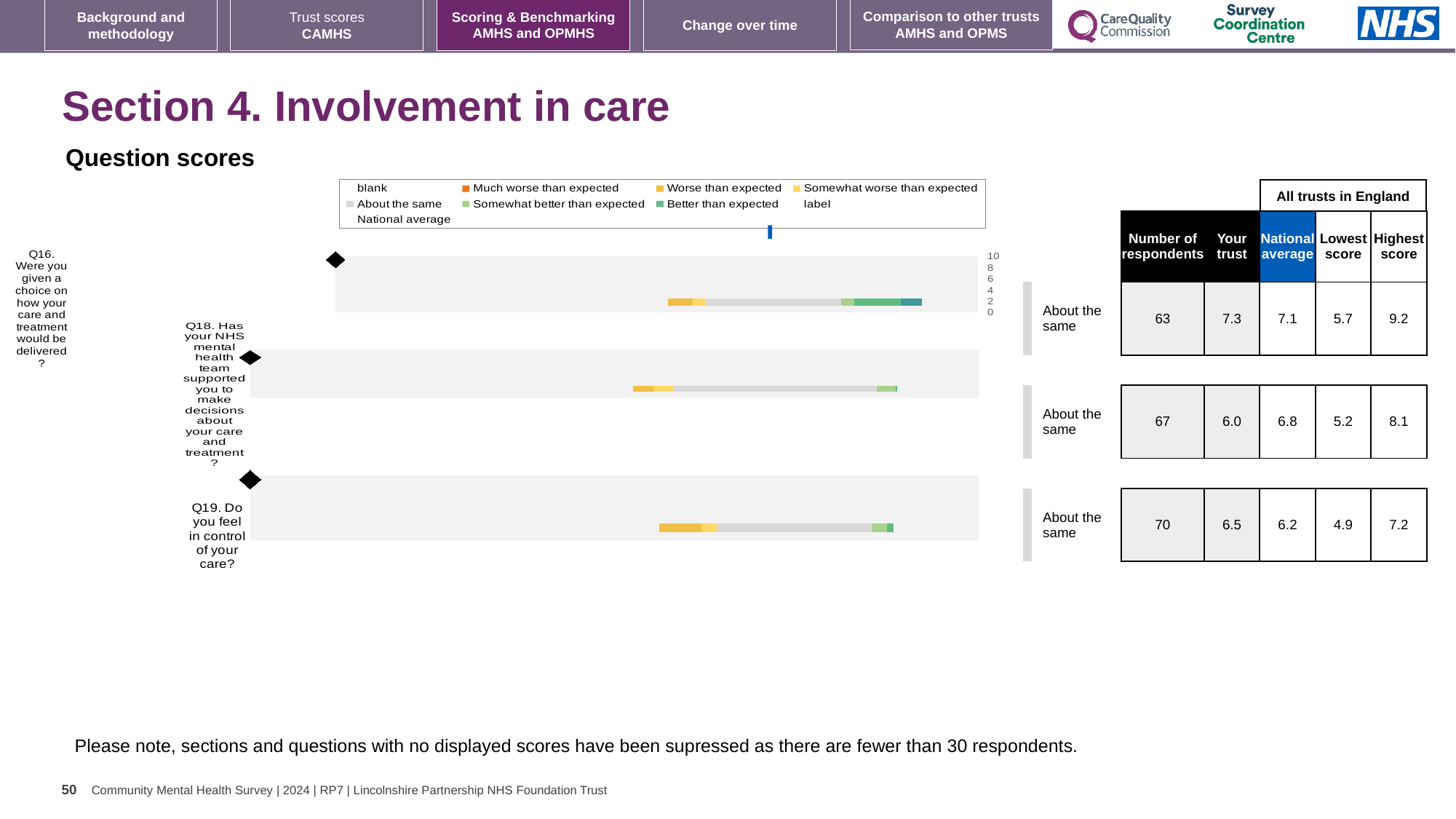
What is the national average score for Q18 (Has your NHS mental health team supported you to make decisions about your care and treatment?)? 6.8 How many questions are plotted in the question scores chart? 3 Which question has the highest 'Your trust' score? Q16 What kind of chart is used to show the question scores on this slide? bar chart What is the 'Your trust' score for Q16 (Were you given a choice on how your care and treatment would be delivered?)? 7.3 For Q18, which is larger: the 'Your trust' score or the national average? National average Which question has the lowest 'Your trust' score? Q18 How many respondents answered Q19 (Do you feel in control of your care?)? 70 What is the highest score across all trusts in England for Q16? 9.2 What is the difference between the 'Your trust' score and the national average for Q16? 0.2 What benchmark category is shown for Q19 in the question scores chart? About the same What is the lowest score across all trusts in England for Q19? 4.9